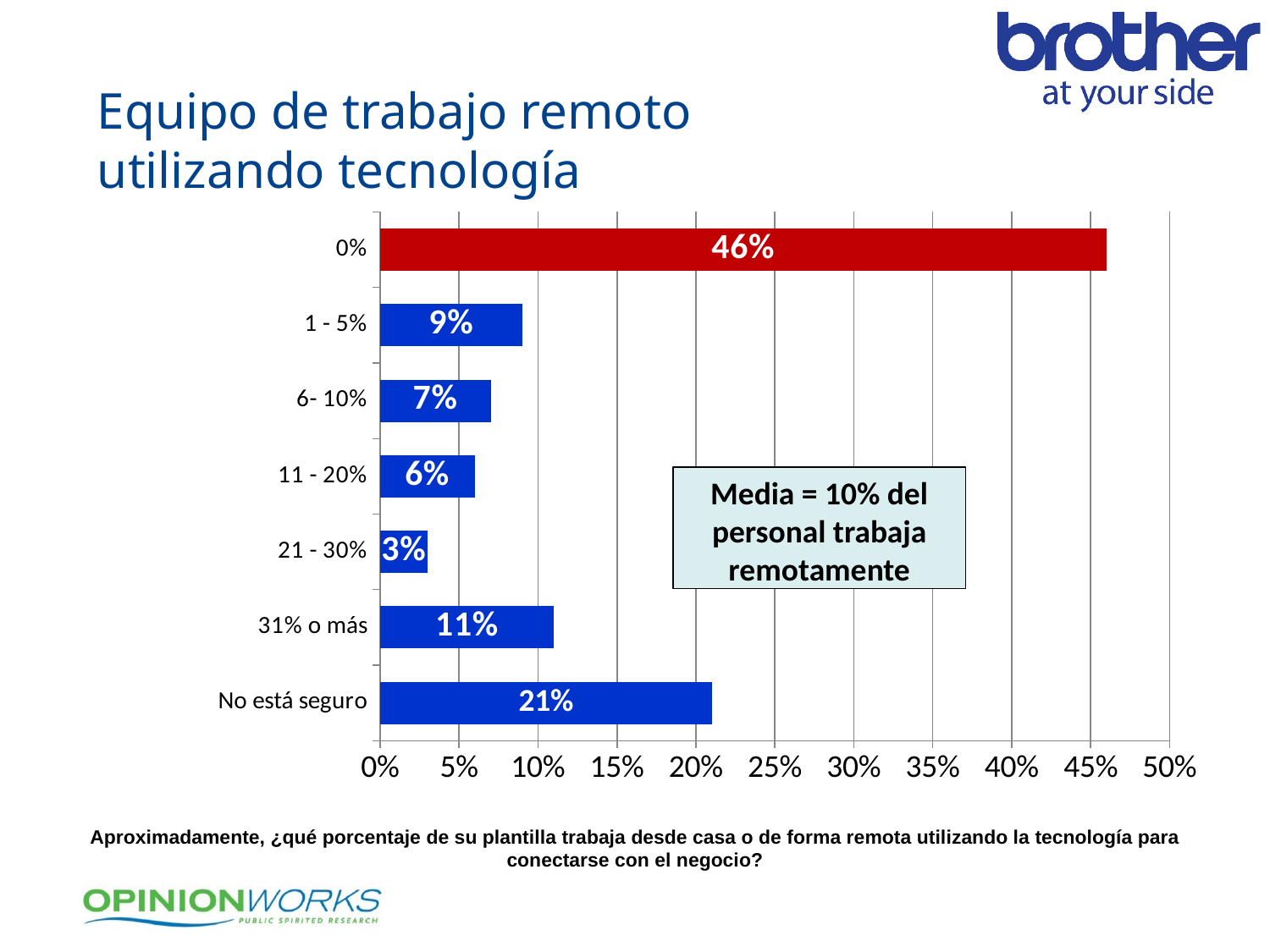
Is the value for "31% o más" greater or less than 10%? greater Which is larger, the value for "1 - 5%" or the value for "6- 10%"? 1 - 5% What is the value for the "No está seguro" category? 21% Which category has the lowest value? 21 - 30% According to the text box on the chart, what is the average percentage of staff working remotely? 10% How many categories are shown in the chart? 7 What kind of chart is shown on the slide? Bar chart What is the value for the "31% o más" category? 11% Which category has the highest value? 0% What is the value for the "21 - 30%" category? 3% What is the difference between the values for "0%" and "No está seguro"? 25% What is the value for the "0%" category? 46%